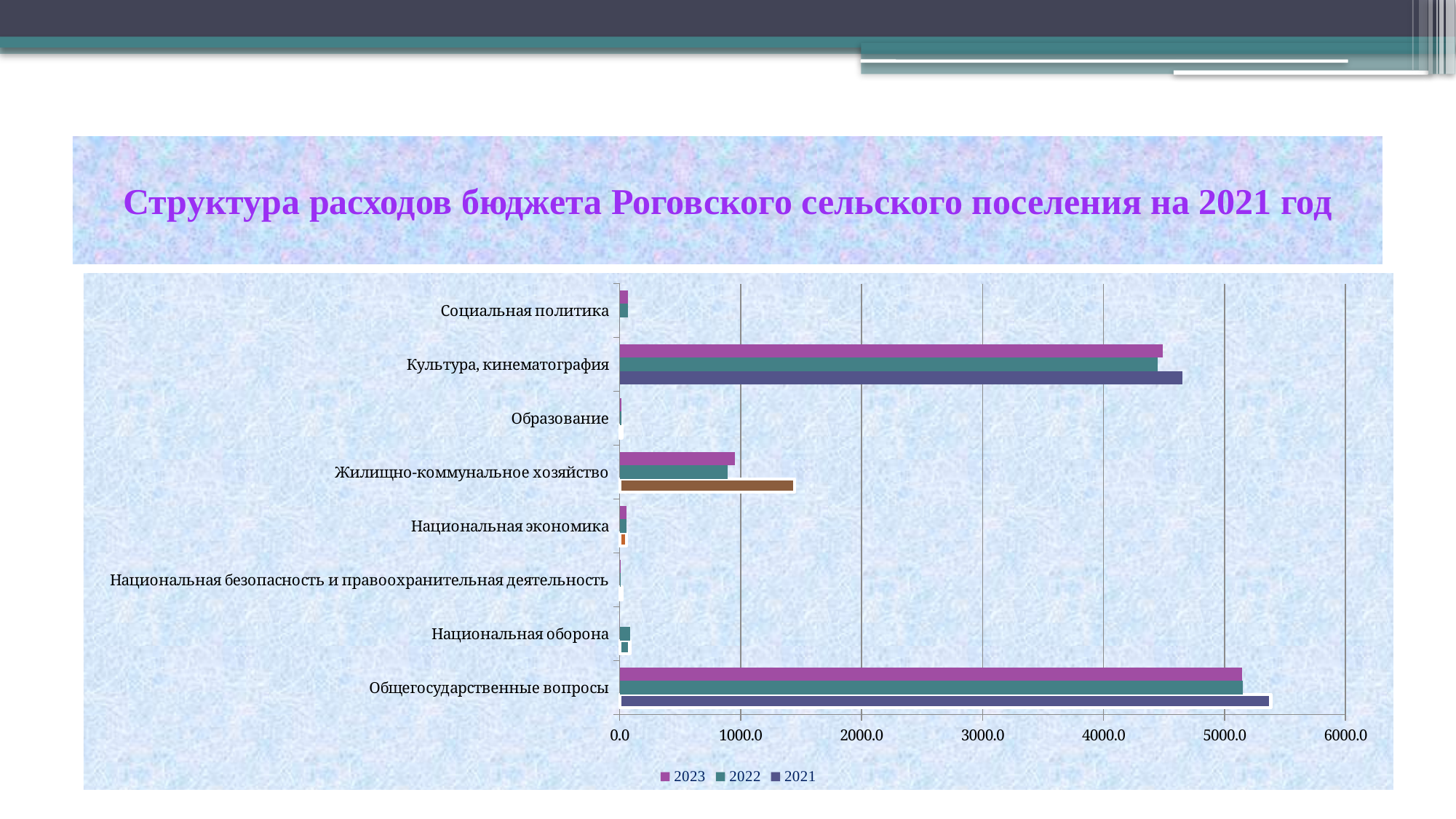
Which years are listed in the chart legend? 2023, 2022, 2021 Which category has the highest value for the 2023 series? Общегосударственные вопросы How many expenditure categories are listed on the vertical axis of the chart? 8 Is the 2021 value for Жилищно-коммунальное хозяйство greater or less than 1000.0? greater Is the 2023 value for Культура, кинематография greater or less than 5000.0? less Is the 2021 value for Культура, кинематография greater or less than 4000.0? greater Which category has the highest value for the 2021 series? Общегосударственные вопросы What kind of chart is shown on the slide? bar chart How many series does the chart legend list? 3 For Жилищно-коммунальное хозяйство, which series has the larger value: 2021 or 2023? 2021 What is the title of the slide above the chart? Структура расходов бюджета Роговского сельского поселения на 2021 год